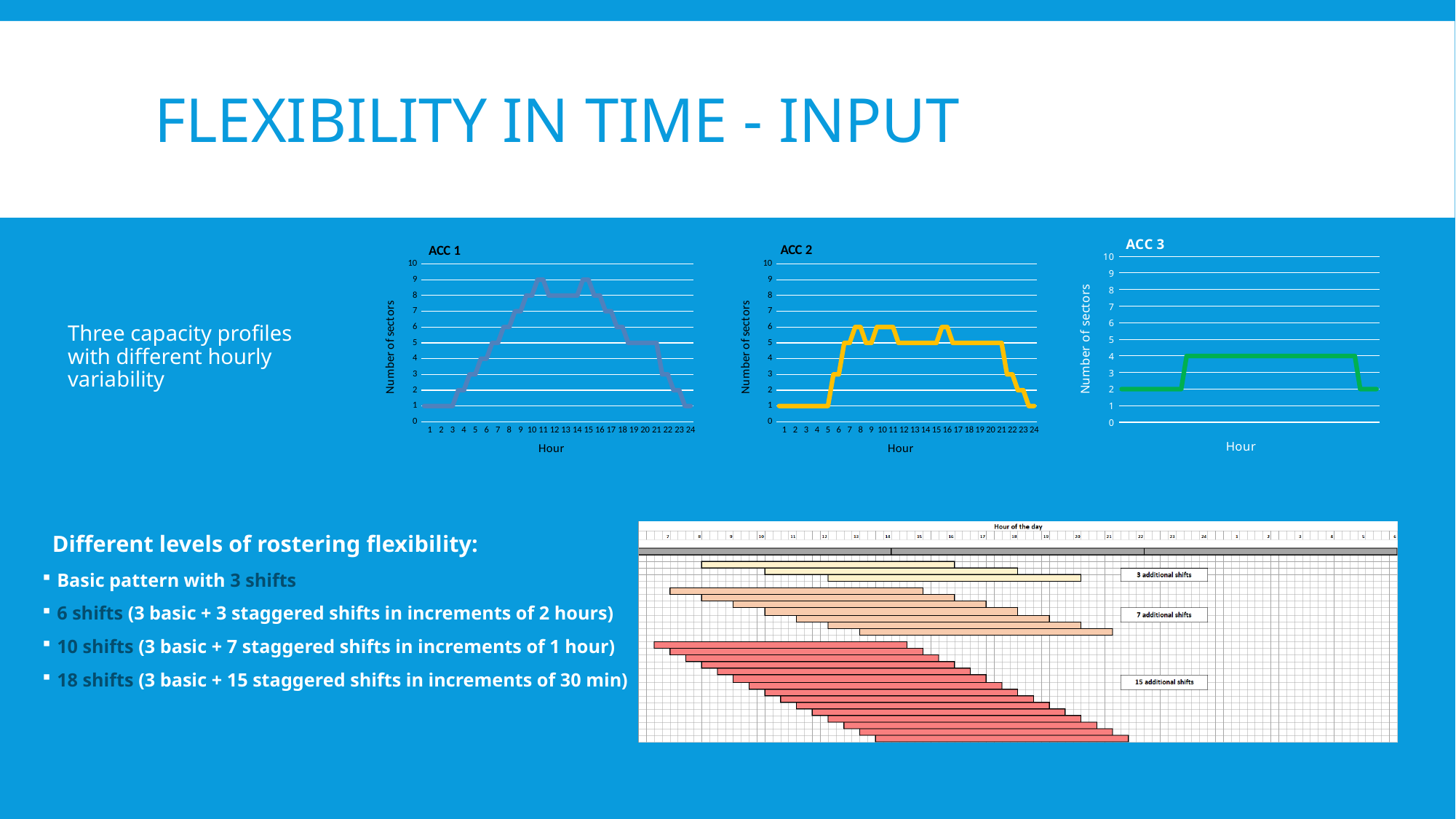
On the ACC 1 chart, what is the number of sectors at hour 1? 1 On the ACC 3 chart, what is the lowest number of sectors shown? 2 What kind of chart is the ACC 1 chart? line chart Which chart reaches a higher peak number of sectors, ACC 1 or ACC 2? ACC 1 On the ACC 3 chart, what is the highest number of sectors reached? 4 On the ACC 1 chart, does the number of sectors rise or fall from hour 3 to hour 10? rise On the ACC 2 chart, what is the highest number of sectors reached? 6 On the ACC 2 chart, is the value at hour 10 greater or less than 5? greater How many hours are labelled on the x axis of the ACC 1 chart? 24 On the ACC 1 chart, what is the highest number of sectors reached? 9 What is the y-axis label on the ACC 2 chart? Number of sectors What is the difference between the peak number of sectors in ACC 1 and the peak in ACC 2? 3